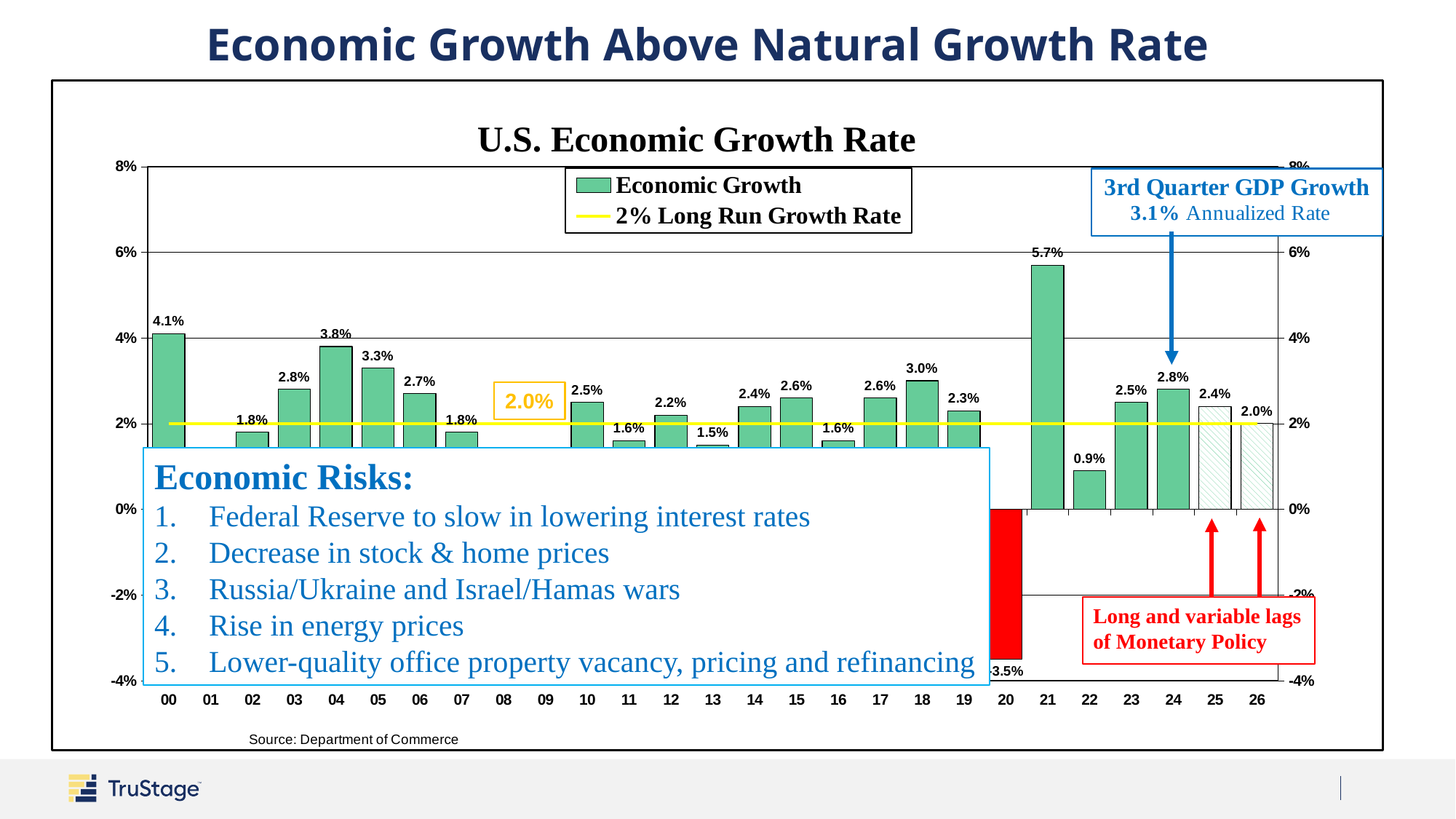
What kind of chart is used to show the economic growth rate? Bar chart What is the economic growth rate shown for 21? 5.7% Which year has the larger growth rate, 18 or 19? 18 Do the growth rates rise or fall from 22 to 24? Rise What is the economic growth rate shown for 20? -3.5% What is the difference between the growth rates for 21 and 22? 4.8% Which year has the highest economic growth rate? 21 How many series does the legend list? 2 What is the difference between the growth rates for 04 and 05? 0.5% What is the economic growth rate shown for 24? 2.8% How many years are shown on the x axis? 27 Which year has the lowest economic growth rate? 20